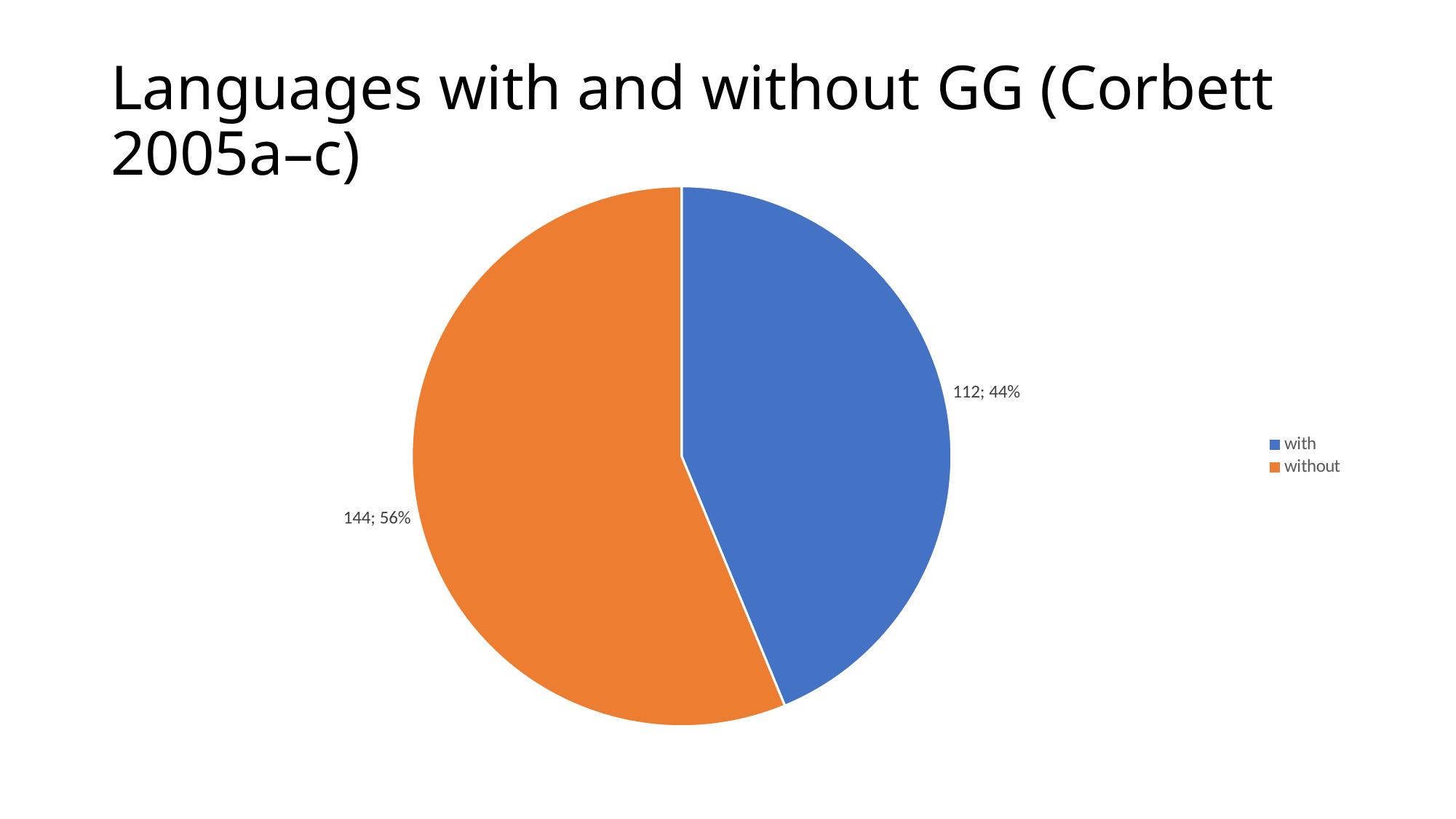
Is the value for 'with' larger or smaller than the value for 'without'? smaller What percentage of the pie does the 'with' slice represent? 44% How many languages are in the 'without' category? 144 Which colour represents the 'without' category? orange Which category has the smaller slice? with What kind of chart is shown on the slide? pie chart What is the total number of languages across both slices? 256 What is the difference between the 'without' and 'with' counts? 32 What percentage of the pie does the 'without' slice represent? 56% Which category has the larger slice? without How many slices does the pie chart have? 2 How many languages are in the 'with' category? 112